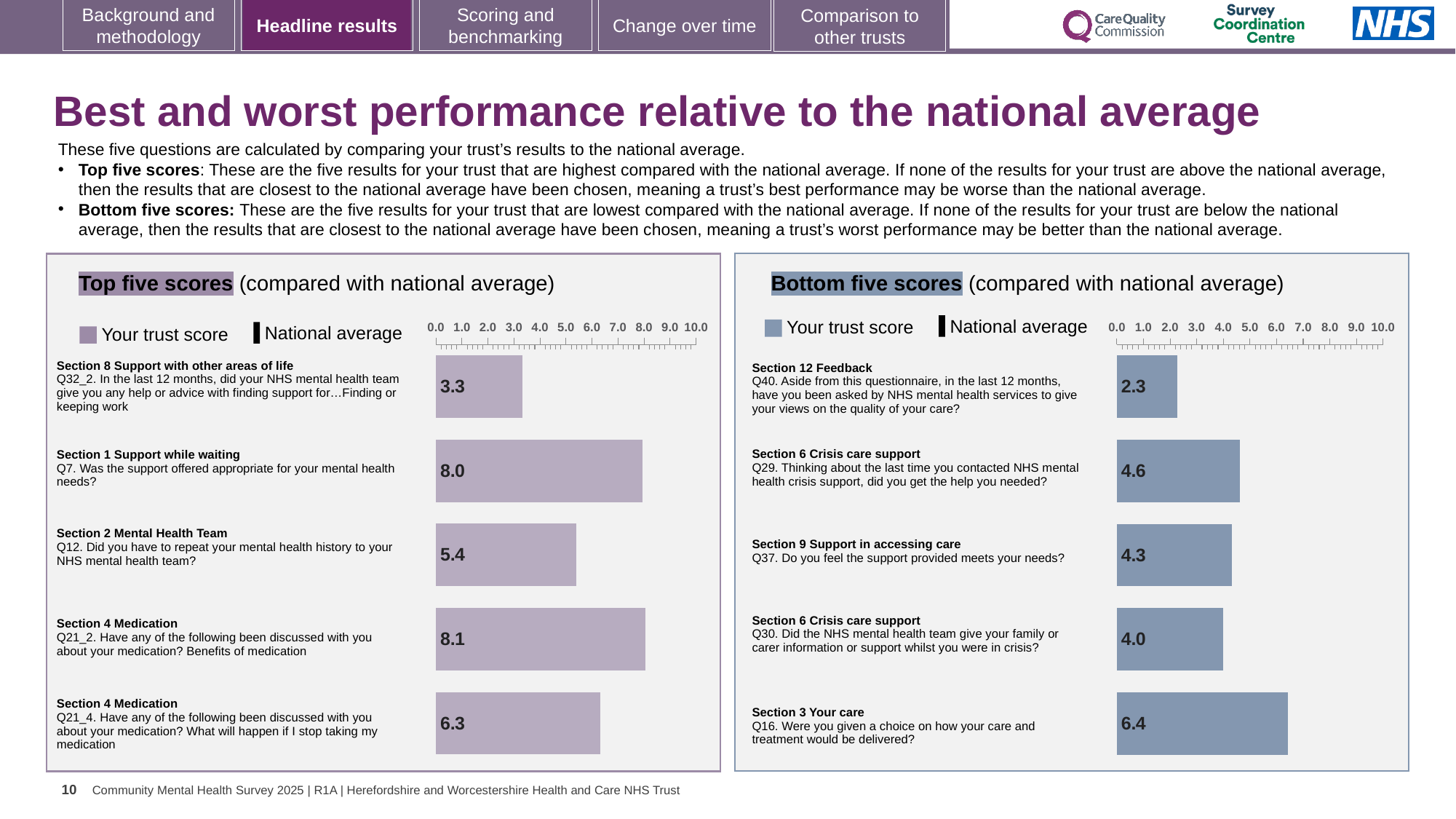
In the Bottom five scores chart, which has the larger trust score, Q29 or Q37? Q29 How many bars are shown in the Top five scores chart? 5 In the Top five scores chart, what is the trust score for Q7 (Was the support offered appropriate for your mental health needs?)? 8.0 What type of chart is used in the Bottom five scores panel? Bar chart In the Bottom five scores chart, what is the difference between the trust scores for Q16 and Q30? 2.4 How many entries does the legend of the Top five scores chart list? 2 In the Bottom five scores chart, which question has the lowest trust score? Q40 In the Bottom five scores chart, what is the trust score for Q40 (have you been asked by NHS mental health services to give your views on the quality of your care?)? 2.3 In the Bottom five scores chart, which question has the highest trust score? Q16 In the Top five scores chart, what is the difference between the trust scores for Q21_2 and Q32_2? 4.8 In the Top five scores chart, which question has the lowest trust score? Q32_2 In the Top five scores chart, what is the trust score for Q21_4 (What will happen if I stop taking my medication)? 6.3